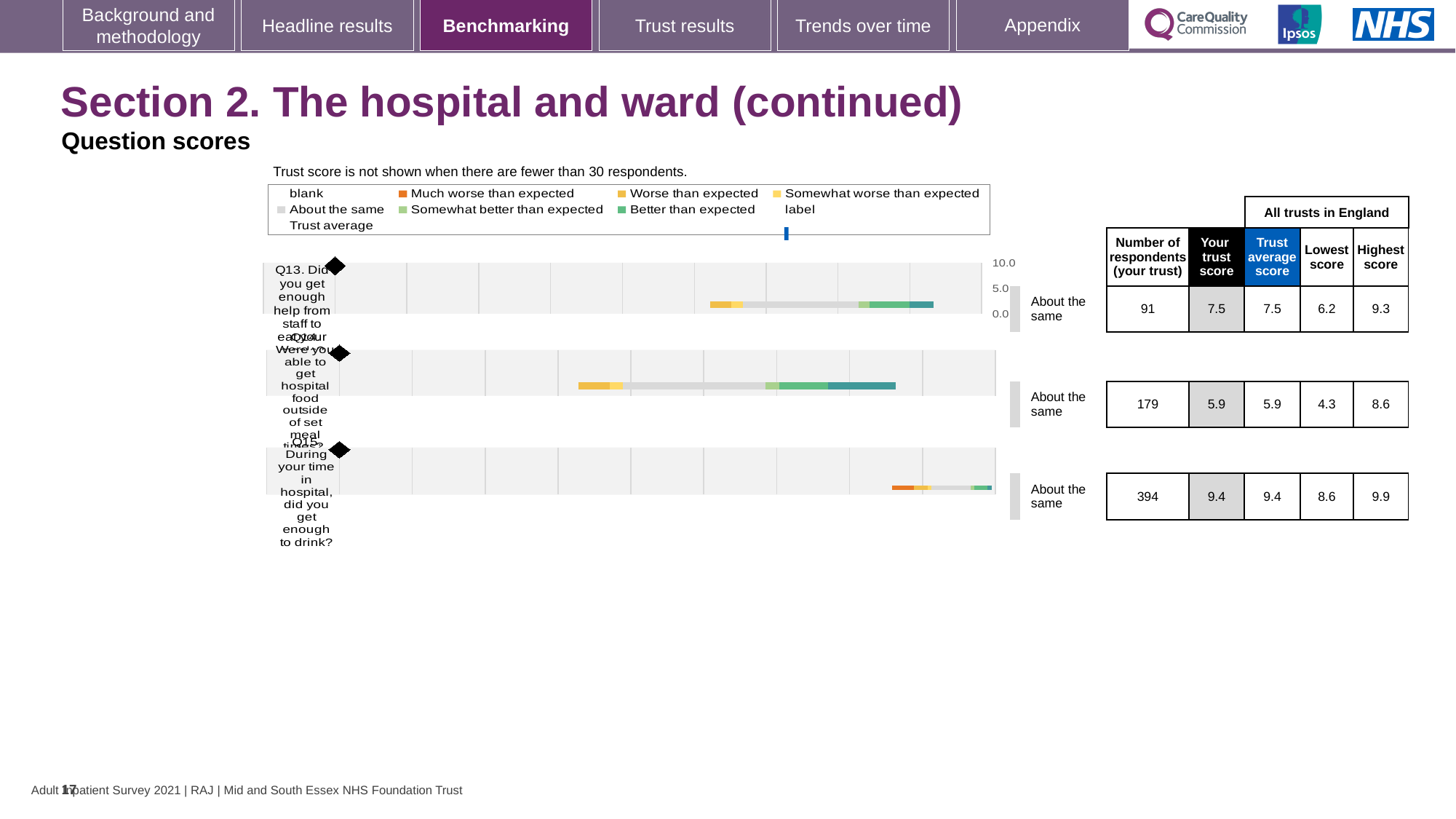
What is the lowest score across all trusts in England for Q14? 4.3 Which question has the lowest trust score on this slide? Q14 What is the highest score across all trusts in England for Q15 (enough to drink)? 9.9 What is the trust score for Q14 (hospital food outside of set meal times)? 5.9 Which question has the highest trust score on this slide? Q15 What benchmark category is shown for Q13 on this slide? About the same What is the number of respondents for Q13 (help from staff to eat meals)? 91 What kind of chart is used to show the question scores on this slide? bar chart What is the difference between the highest score (9.3) and the lowest score (6.2) for Q13? 3.1 Which question has more respondents, Q13 or Q15? Q15 How many questions (Q13, Q14, Q15) have a benchmarking bar on this slide? 3 What is the maximum value shown on the score axis of the charts? 10.0